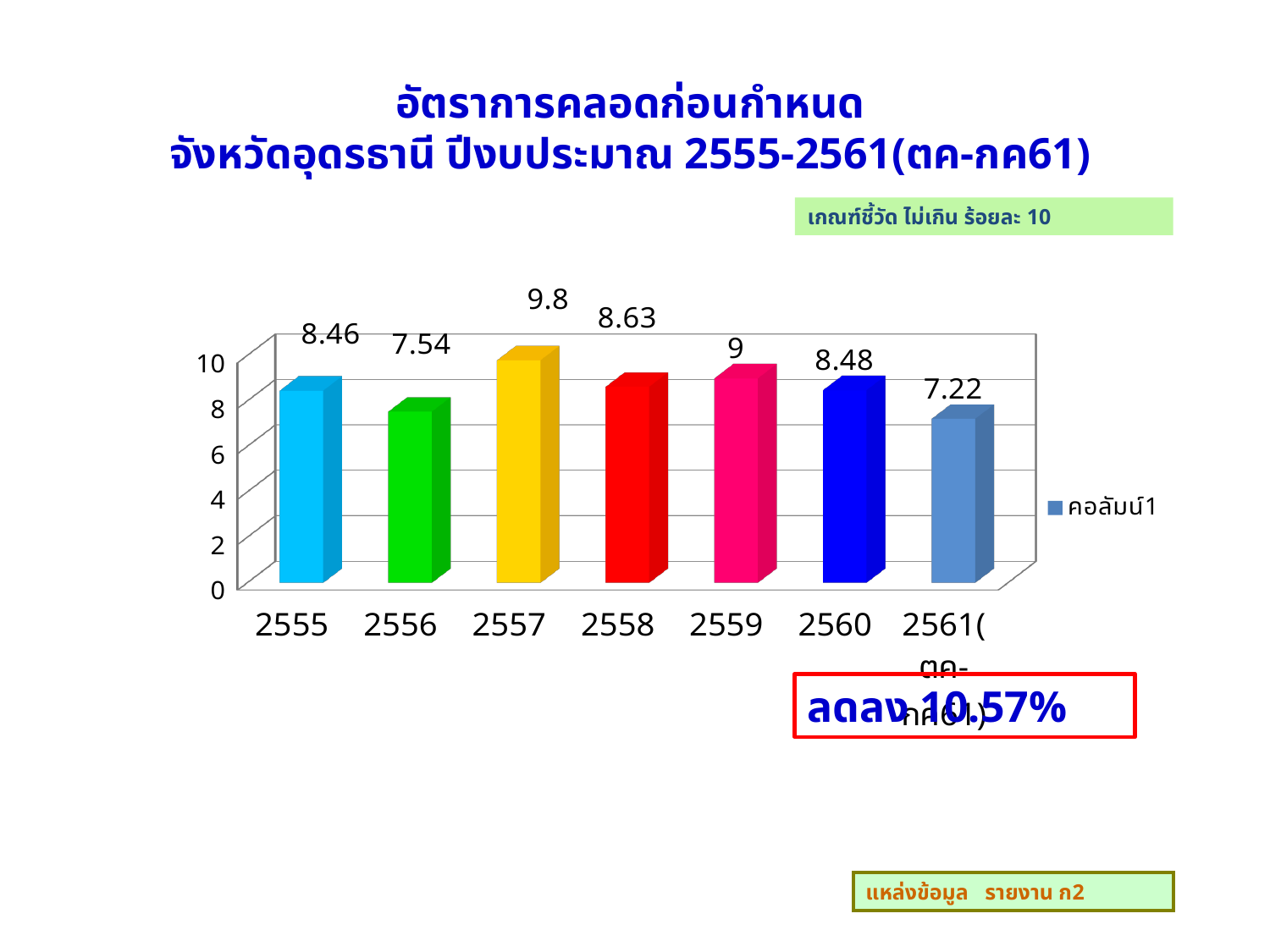
Which year has the highest value? 2557 What is the legend entry shown on the chart? คอลัมน์1 Is the value for 2557 greater or less than 8? greater What is the value for 2559? 9 What kind of chart is shown on the slide? bar chart How many years are shown on the x axis? 7 What is the difference between the values for 2558 and 2556? 1.09 Which is larger, the value for 2559 or the value for 2556? 2559 What is the difference between the values for 2557 and 2561(ตค-กค61)? 2.58 What is the value for 2557? 9.8 What is the value for 2561(ตค-กค61)? 7.22 Which year has the lowest value? 2561(ตค-กค61)